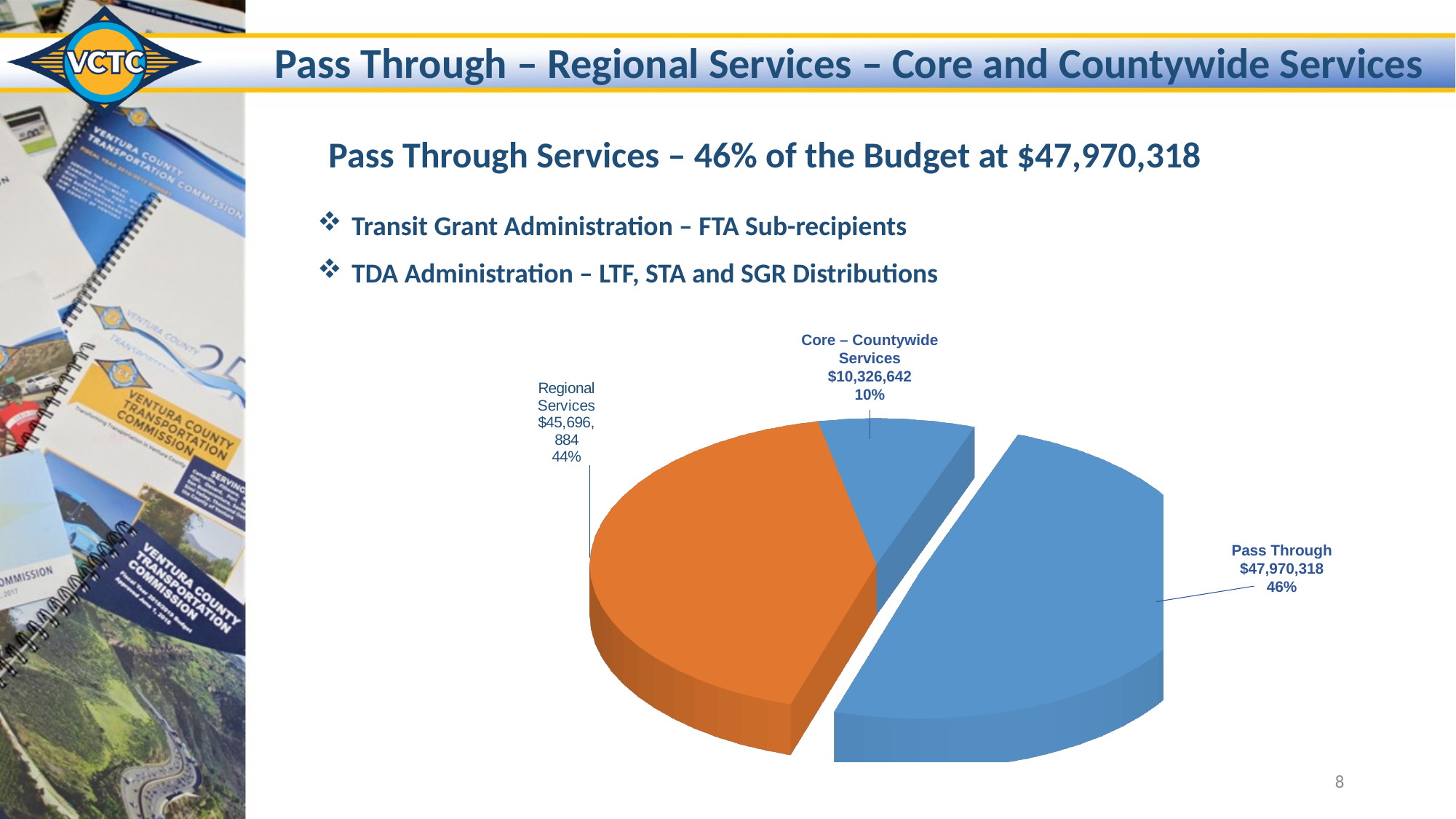
Which slice of the pie chart is the largest? Pass Through What kind of chart is shown on the slide? Pie chart What share of the pie does Core – Countywide Services represent? 10% What is the difference in value between Pass Through and Core – Countywide Services? $37,643,676 Which slice of the pie chart is the smallest? Core – Countywide Services What share of the pie does Pass Through represent? 46% What is the value shown for Pass Through in the pie chart? $47,970,318 Which slice is pulled out (exploded) from the rest of the pie? Pass Through What is the value shown for Core – Countywide Services in the pie chart? $10,326,642 What is the value shown for Regional Services in the pie chart? $45,696,884 How many slices does the pie chart have? 3 What share of the pie does Regional Services represent? 44%